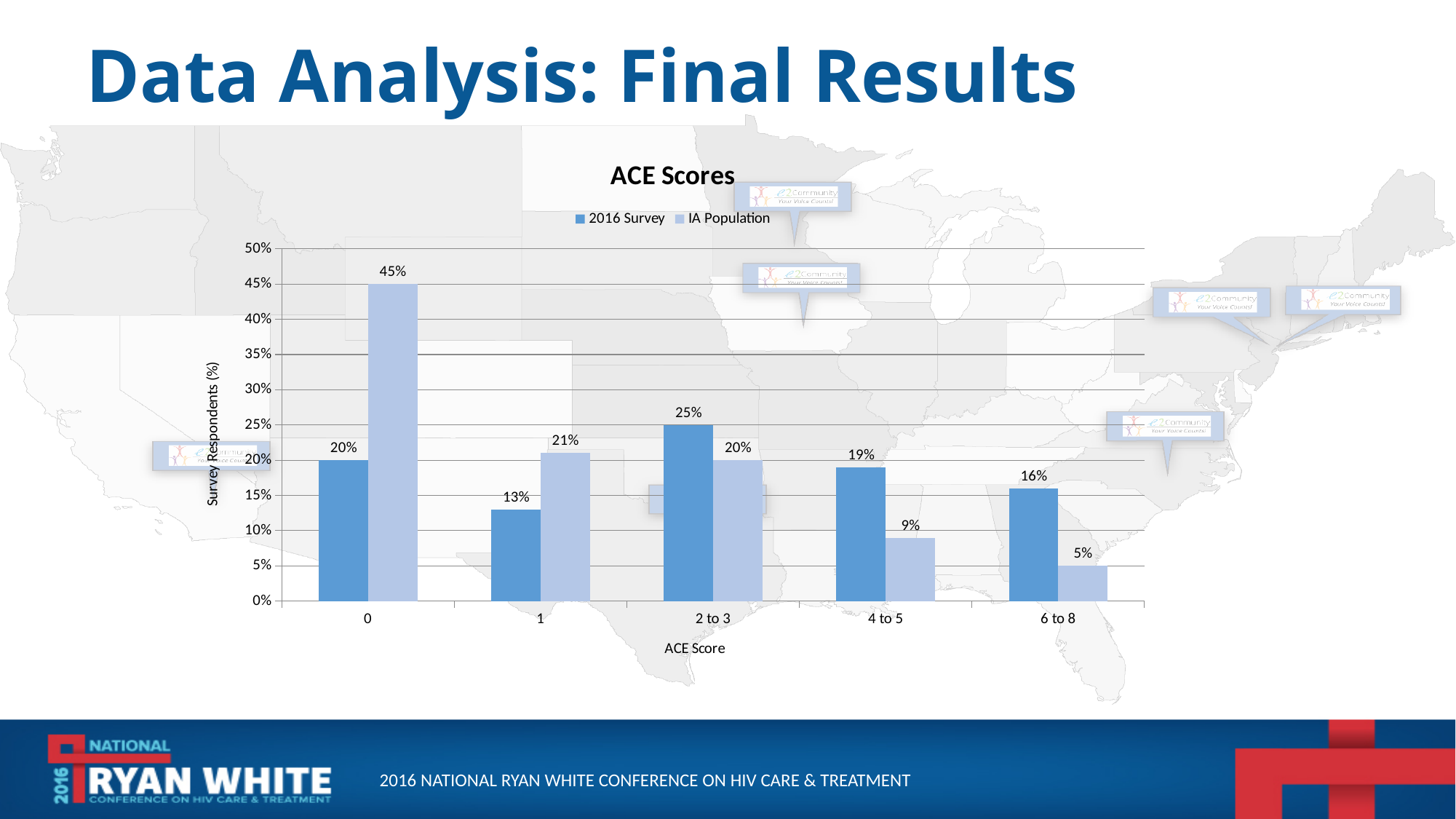
What kind of chart is shown on the slide? Bar chart What is the IA Population value for ACE score 0? 45% What is the 2016 Survey value for ACE score 2 to 3? 25% How many ACE score categories are shown on the x axis? 5 What is the difference between the IA Population and 2016 Survey values for ACE score 0? 25% Which ACE score category has the highest 2016 Survey value? 2 to 3 How many series does the legend list? 2 For ACE score 4 to 5, which series has the larger value, 2016 Survey or IA Population? 2016 Survey What is the IA Population value for ACE score 6 to 8? 5% What is the title of the chart? ACE Scores Which ACE score category has the lowest IA Population value? 6 to 8 What is the 2016 Survey value for ACE score 0? 20%